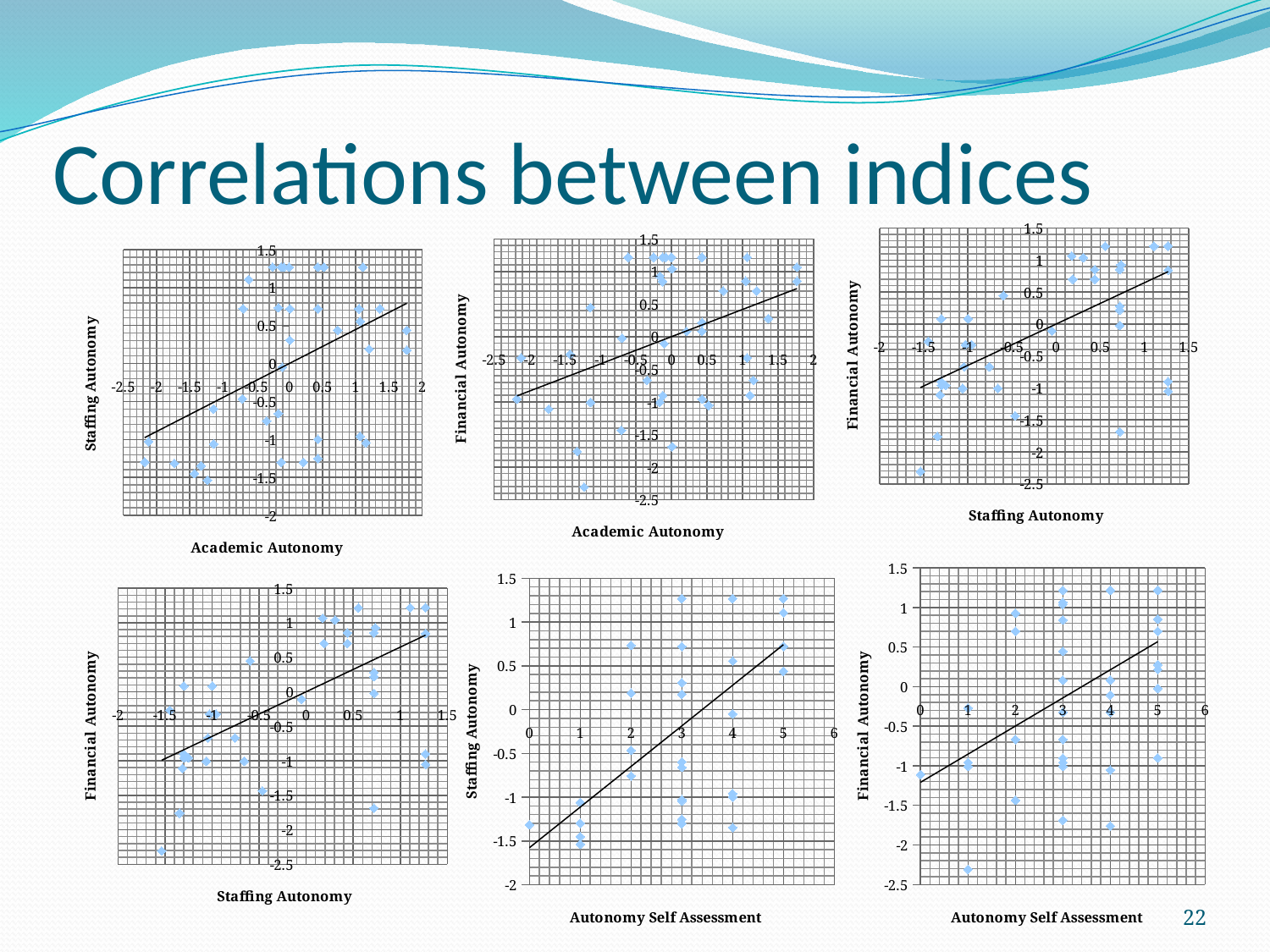
In the bottom-middle chart with Autonomy Self Assessment on the x axis and Staffing Autonomy on the y axis, does the fitted trend line rise or fall as the x value increases? Rise What is the highest value shown on the x axis of the bottom-middle chart with Autonomy Self Assessment on the x axis and Staffing Autonomy on the y axis? 6 How many charts are shown on the slide? 6 What kind of chart is the top-left chart with Academic Autonomy on the x axis and Staffing Autonomy on the y axis? Scatter chart What is the lowest value shown on the y axis of the top-middle chart with Academic Autonomy on the x axis and Financial Autonomy on the y axis? -2.5 In the top-middle chart with Academic Autonomy on the x axis and Financial Autonomy on the y axis, does the trend line rise or fall from left to right? Rise In the bottom-right chart with Autonomy Self Assessment on the x axis and Financial Autonomy on the y axis, does the trend line rise or fall along the x axis? Rise